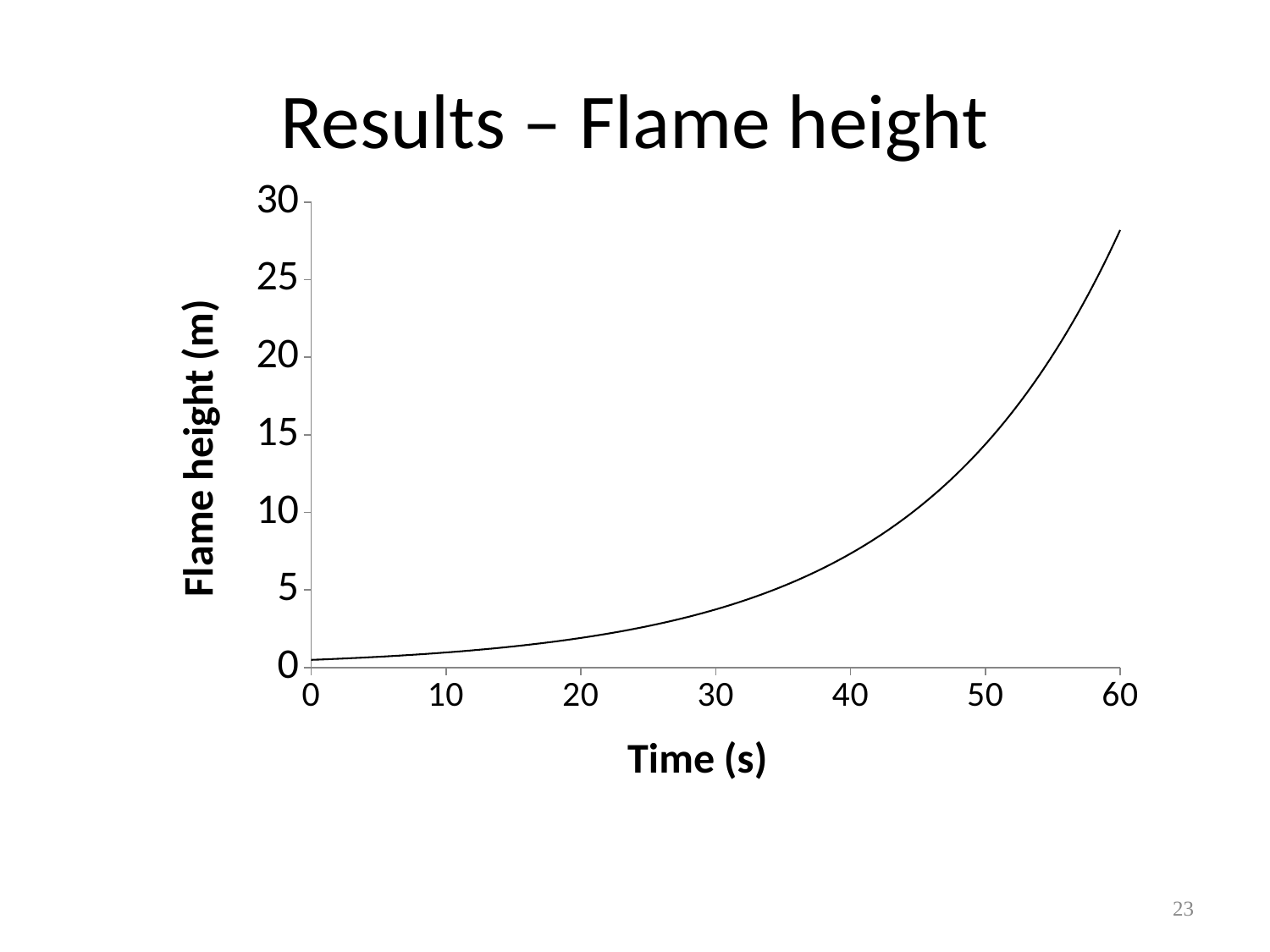
At which time on the x axis is the flame height lowest? 0 Is the flame height larger at 50 s or at 30 s? 50 s Is the flame height at 20 s greater or less than 5 m? less At which time on the x axis is the flame height highest? 60 Is the flame height at 40 s greater or less than 10 m? less Is the flame height at 55 s greater or less than 15 m? greater What is the title of the y axis? Flame height (m) What kind of chart is shown on the slide? line chart Does the flame height rise or fall as time increases? rise What is the title of the x axis? Time (s)